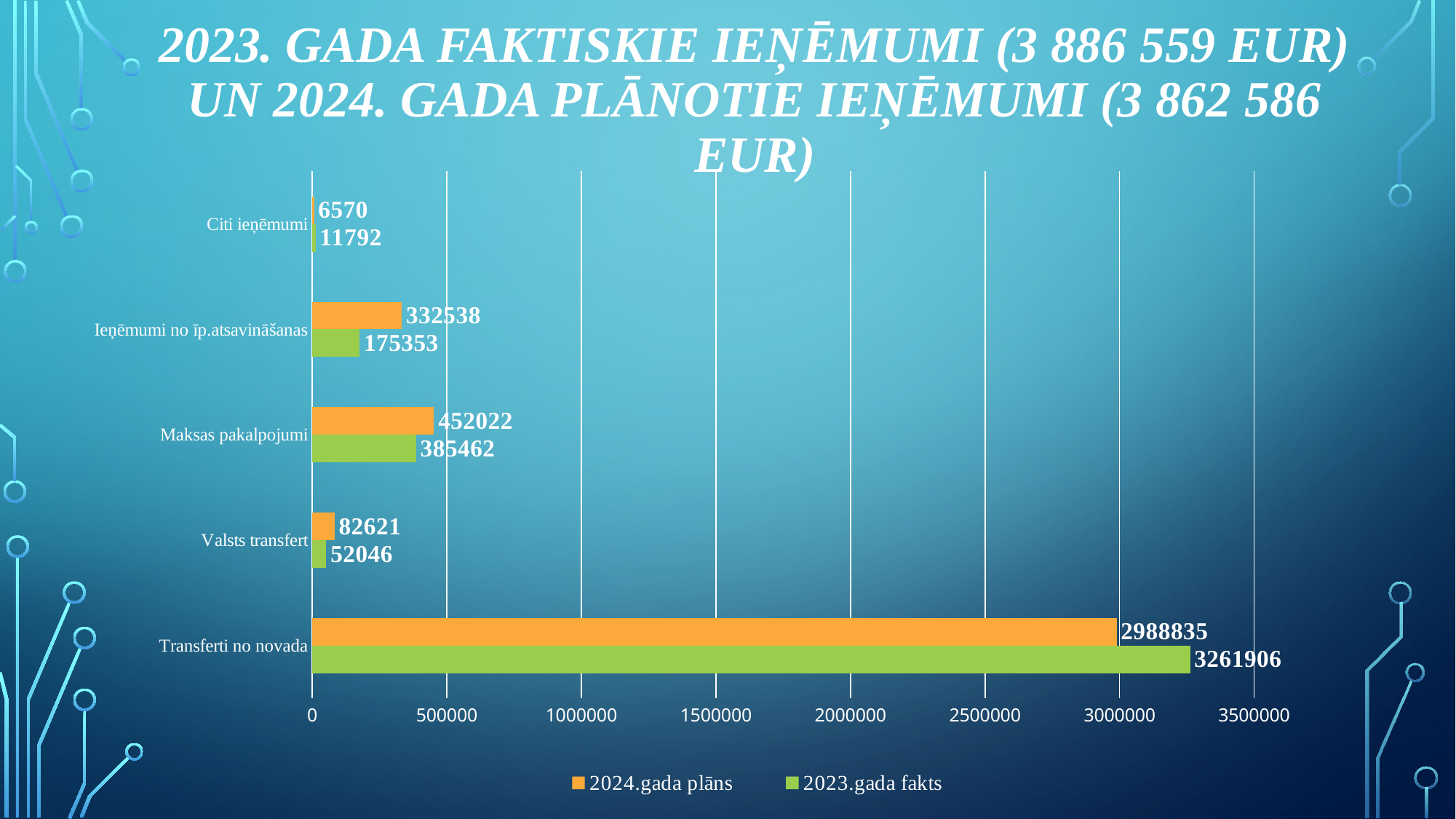
For Ieņēmumi no īp.atsavināšanas, which is larger: the 2024.gada plāns value or the 2023.gada fakts value? 2024.gada plāns What is the 2023.gada fakts value for Transferti no novada? 3261906 What is the 2023.gada fakts value for Citi ieņēmumi? 11792 What kind of chart is shown on the slide? Bar chart What is the difference between the 2023.gada fakts and 2024.gada plāns values for Transferti no novada? 273071 How many categories are shown on the chart? 5 How many series does the legend list? 2 What is the 2024.gada plāns value for Maksas pakalpojumi? 452022 What is the difference between the 2024.gada plāns and 2023.gada fakts values for Maksas pakalpojumi? 66560 What is the 2024.gada plāns value for Valsts transfert? 82621 Which category has the highest 2024.gada plāns value? Transferti no novada Which category has the lowest 2023.gada fakts value? Citi ieņēmumi